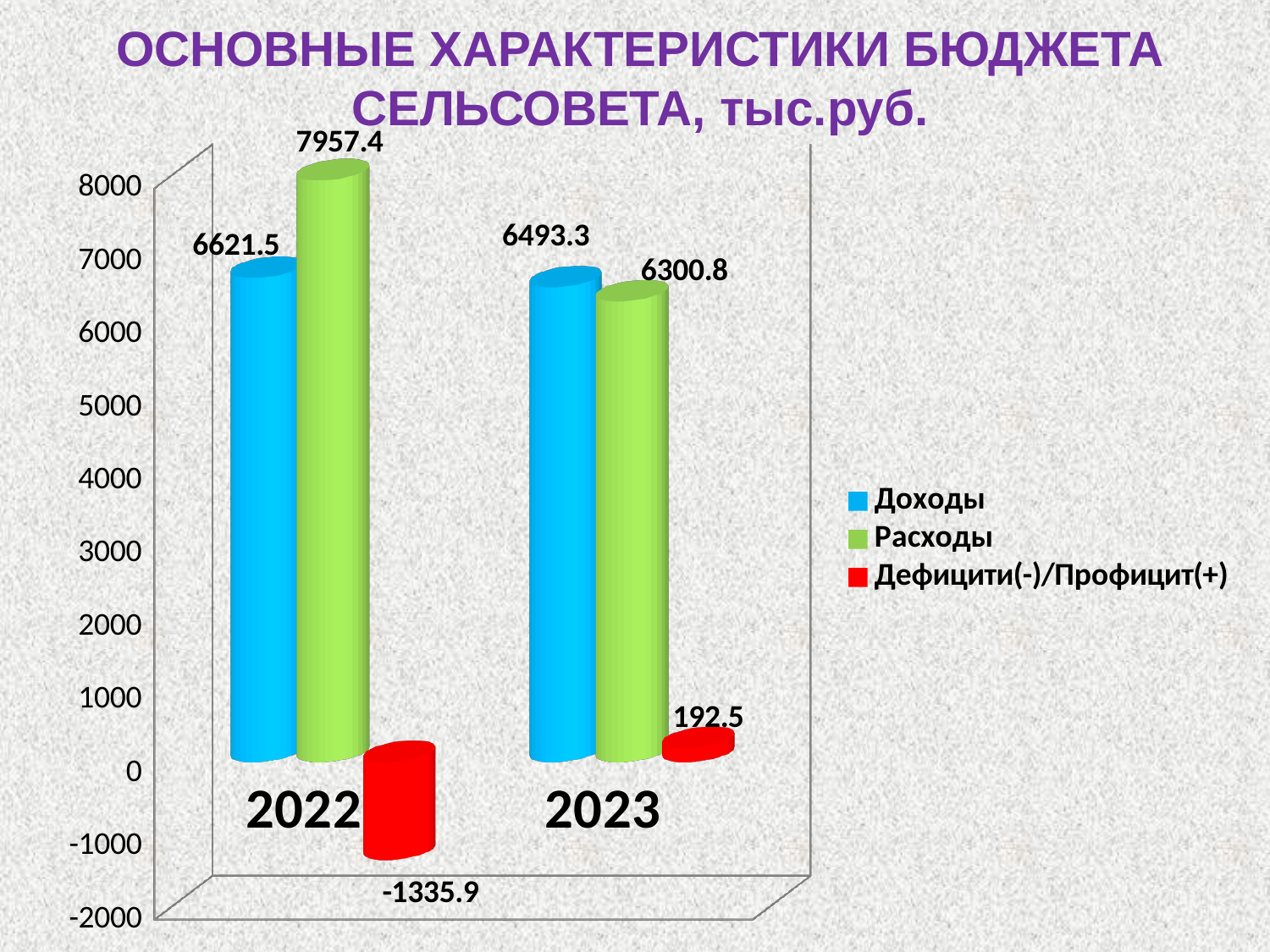
What is the value of Дефицити(-)/Профицит(+) for 2022? -1335.9 What is the difference between Доходы in 2022 and Доходы in 2023? 128.2 What is the difference between Расходы and Доходы in 2022? 1335.9 How many series does the legend list? 3 Which year has the lower value of Доходы? 2023 How many years are shown on the x axis? 2 What kind of chart is shown on the slide? Bar chart What is the value of Дефицити(-)/Профицит(+) for 2023? 192.5 What is the value of Расходы for 2023? 6300.8 Which year has the higher value of Расходы? 2022 In 2023, which is larger, Доходы or Расходы? Доходы What is the value of Доходы for 2022? 6621.5